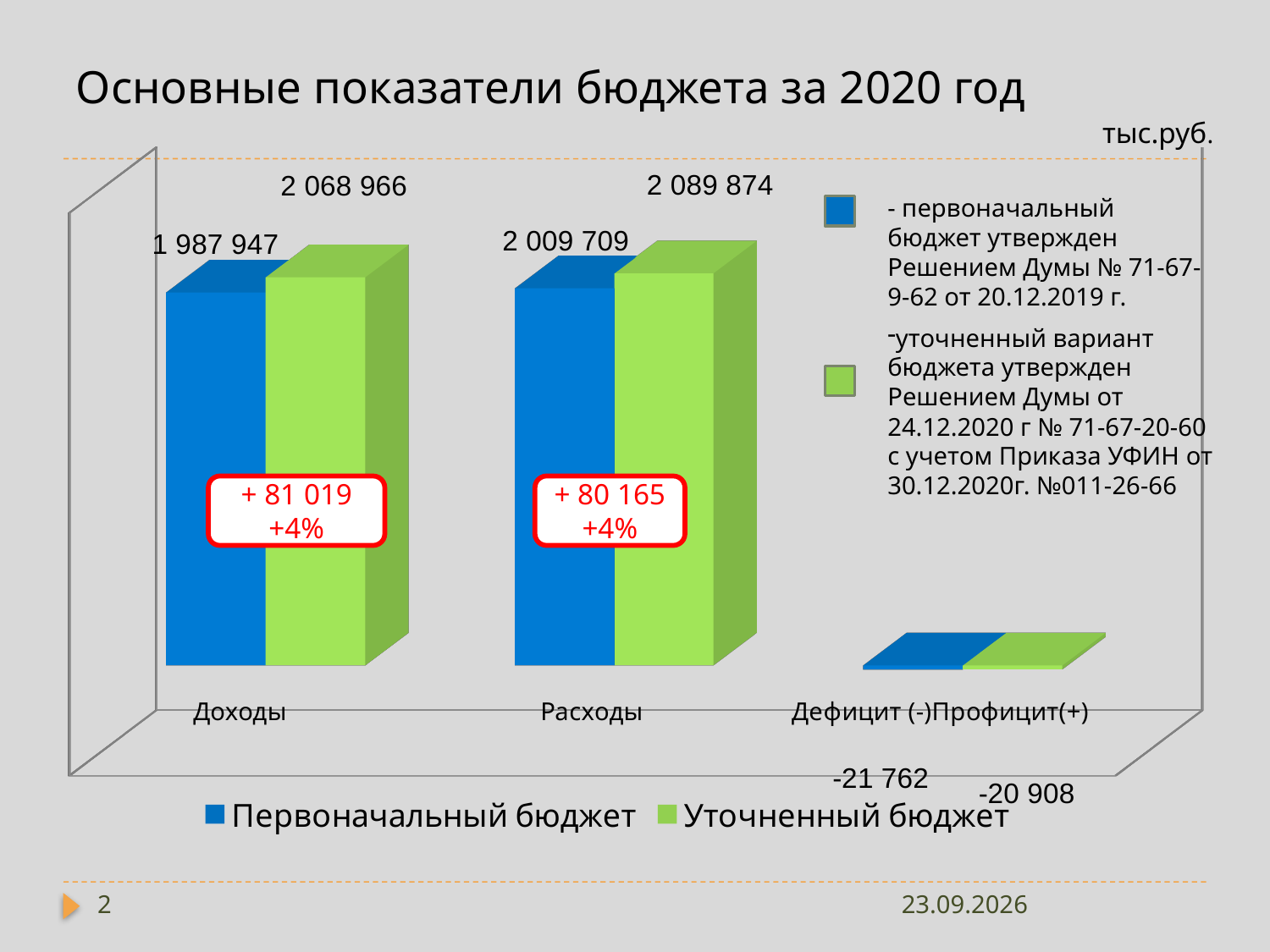
What is the value for Расходы in the Уточненный бюджет series? 2 089 874 What is the difference between the Уточненный бюджет and Первоначальный бюджет values for Расходы? 80 165 What type of chart is shown on the slide? Bar chart What is the value for Доходы in the Уточненный бюджет series? 2 068 966 Which category has the highest value in the Уточненный бюджет series? Расходы What is the value for Дефицит (-)Профицит(+) in the Уточненный бюджет series? -20 908 What is the value for Дефицит (-)Профицит(+) in the Первоначальный бюджет series? -21 762 What is the value for Доходы in the Первоначальный бюджет series? 1 987 947 Which is larger for Доходы: the Первоначальный бюджет value or the Уточненный бюджет value? Уточненный бюджет How many series does the chart legend list? 2 Which category has the lowest value in the Первоначальный бюджет series? Дефицит (-)Профицит(+) What is the value for Расходы in the Первоначальный бюджет series? 2 009 709